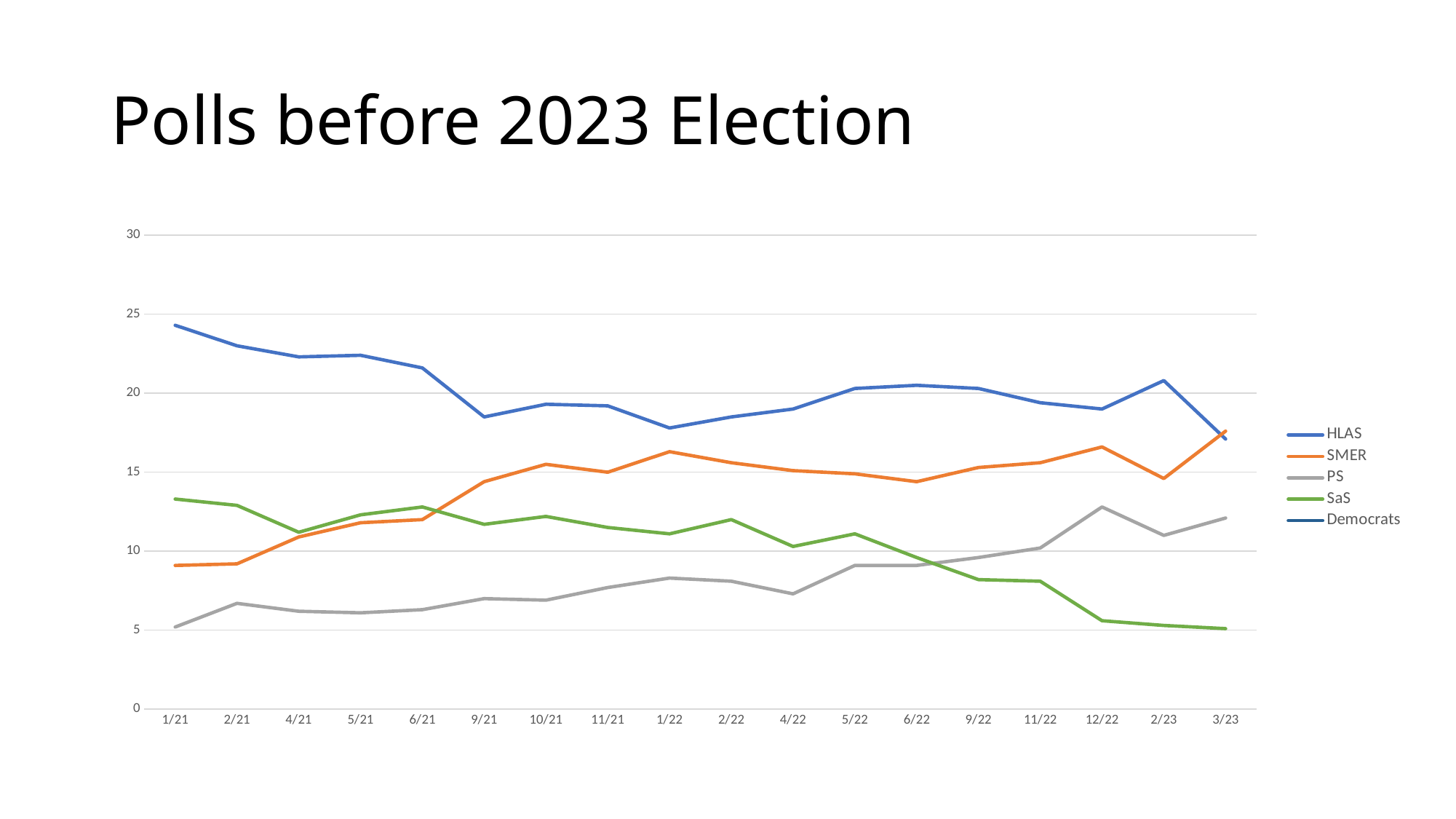
Does the PS line rise or fall from 1/21 to 3/23? rise Is the value for PS at 12/22 greater or less than 10? greater What kind of chart is shown on the slide? line chart Does the SaS line rise or fall from 1/21 to 3/23? fall Is the value for HLAS at 1/21 greater or less than 20? greater Is the value for SaS at 3/23 greater or less than 10? less How many series does the legend list? 5 How many points are there along the x axis? 18 Which series has the highest value at 1/21? HLAS What is the title of the chart? Polls before 2023 Election